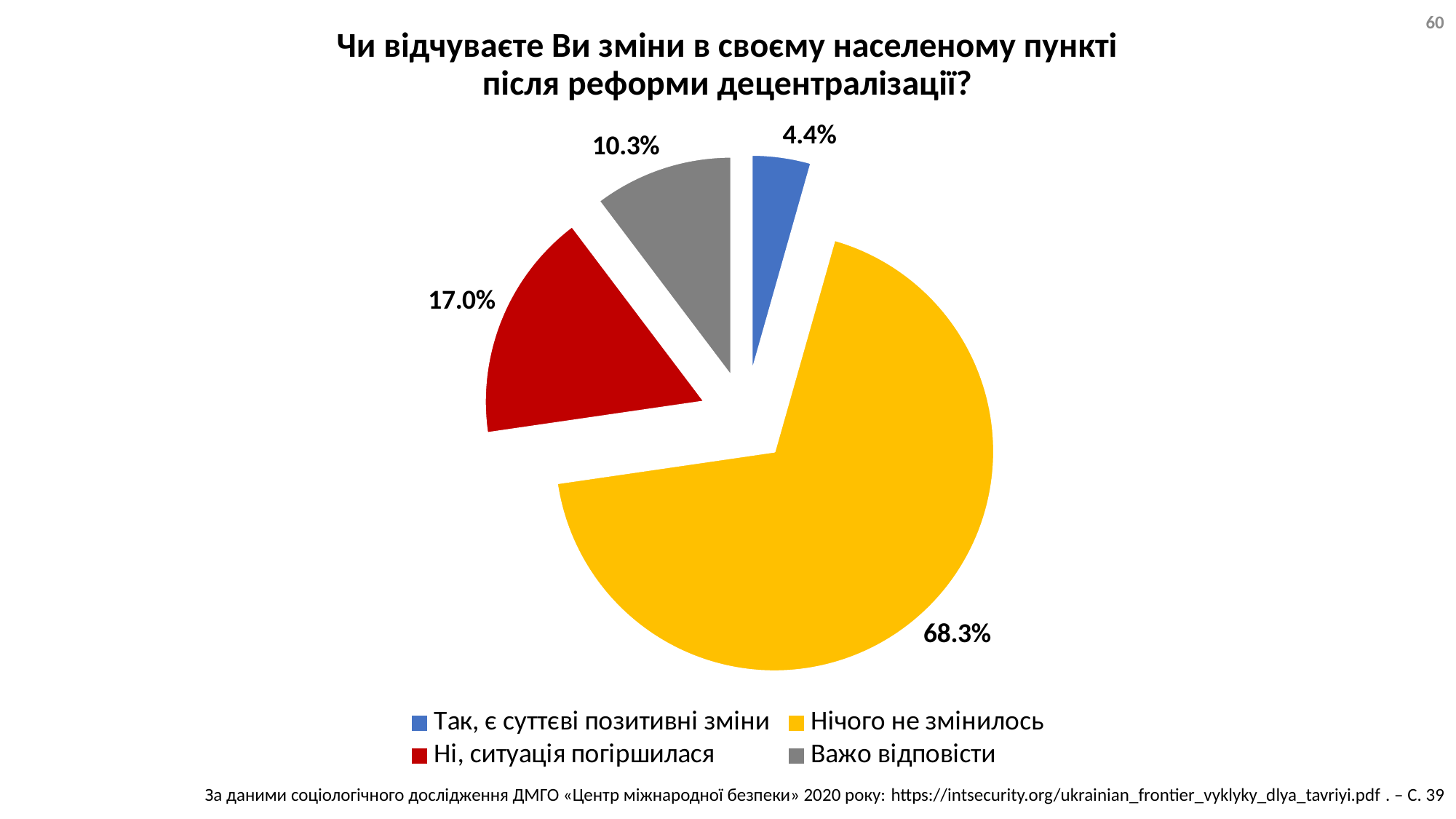
What is the difference in percentage points between "Ні, ситуація погіршилася" and "Важо відповісти"? 6.7 What type of chart is shown on the slide? Pie chart What is the title of the chart? Чи відчуваєте Ви зміни в своєму населеному пункті після реформи децентралізації? What share of respondents answered "Важо відповісти"? 10.3% Which answer option has the largest share of the pie? Нічого не змінилось Which answer option has the smallest share of the pie? Так, є суттєві позитивні зміни What share of respondents answered "Так, є суттєві позитивні зміни"? 4.4% What share of respondents answered "Ні, ситуація погіршилася"? 17.0% Which is larger: the share for "Ні, ситуація погіршилася" or the share for "Важо відповісти"? Ні, ситуація погіршилася What colour is the slice for "Нічого не змінилось"? Yellow How many slices does the pie chart have? 4 What share of respondents answered "Нічого не змінилось"? 68.3%